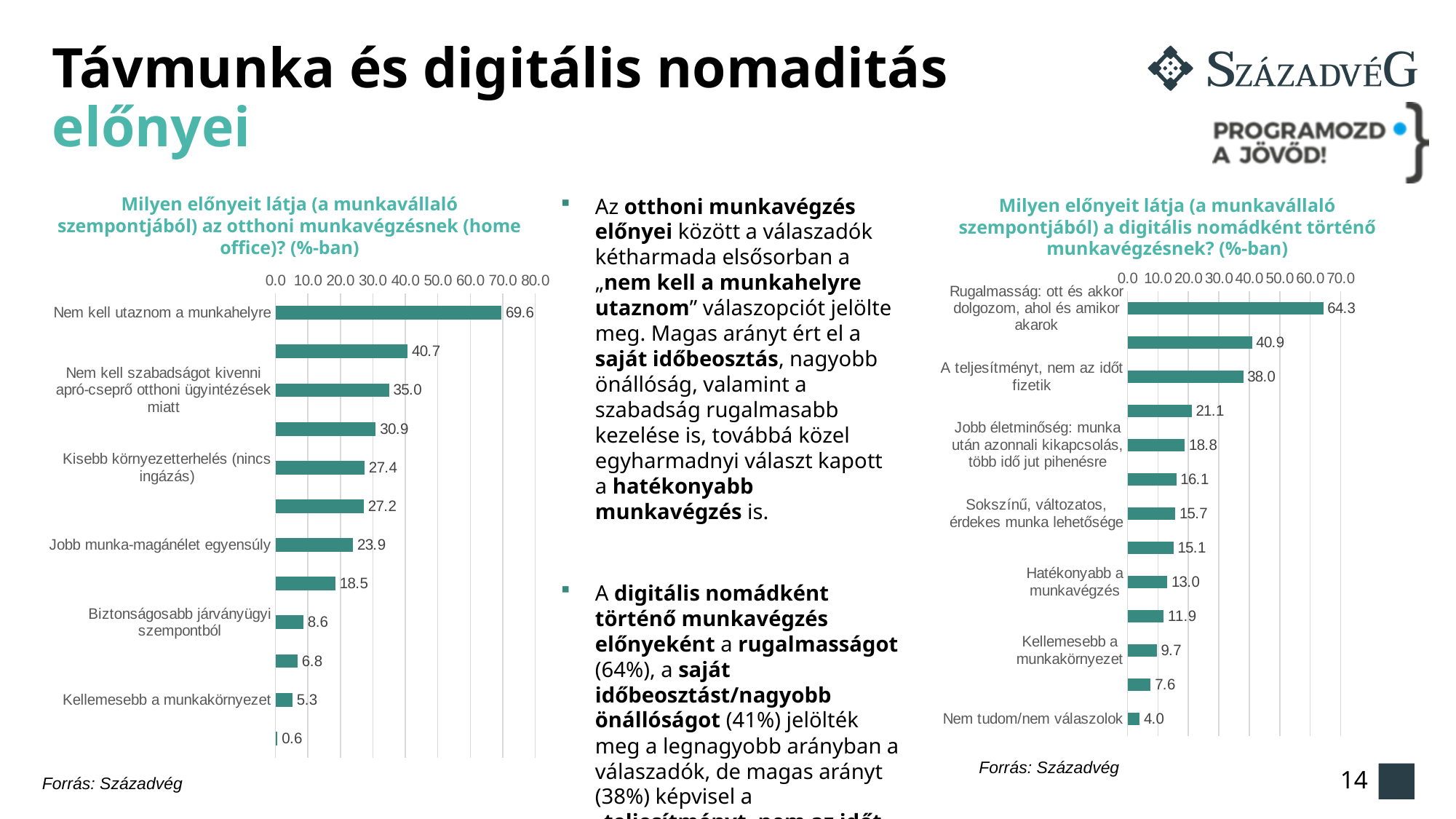
In the left chart (home office benefits), which category has the highest value? Nem kell utaznom a munkahelyre In the left chart (home office benefits), what is the value for "Nem kell utaznom a munkahelyre"? 69.6 In the left chart (home office benefits), what is the value for "Jobb munka-magánélet egyensúly"? 23.9 In the right chart (digital nomad benefits), what is the value for "Nem tudom/nem válaszolok"? 4.0 What source is cited below both charts? Századvég In the right chart (digital nomad benefits), which category has the highest value? Rugalmasság: ott és akkor dolgozom, ahol és amikor akarok In the right chart (digital nomad benefits), what is the value for "A teljesítményt, nem az időt fizetik"? 38.0 In the right chart (digital nomad benefits), which is larger: "Hatékonyabb a munkavégzés" or "Kellemesebb a munkakörnyezet"? Hatékonyabb a munkavégzés In the left chart (home office benefits), how many bars are plotted? 12 In the right chart (digital nomad benefits), what is the difference between "Rugalmasság: ott és akkor dolgozom, ahol és amikor akarok" and "A teljesítményt, nem az időt fizetik"? 26.3 What type of chart is the right chart (digital nomad benefits)? Bar chart In the left chart (home office benefits), what is the difference between "Nem kell utaznom a munkahelyre" and "Kellemesebb a munkakörnyezet"? 64.3